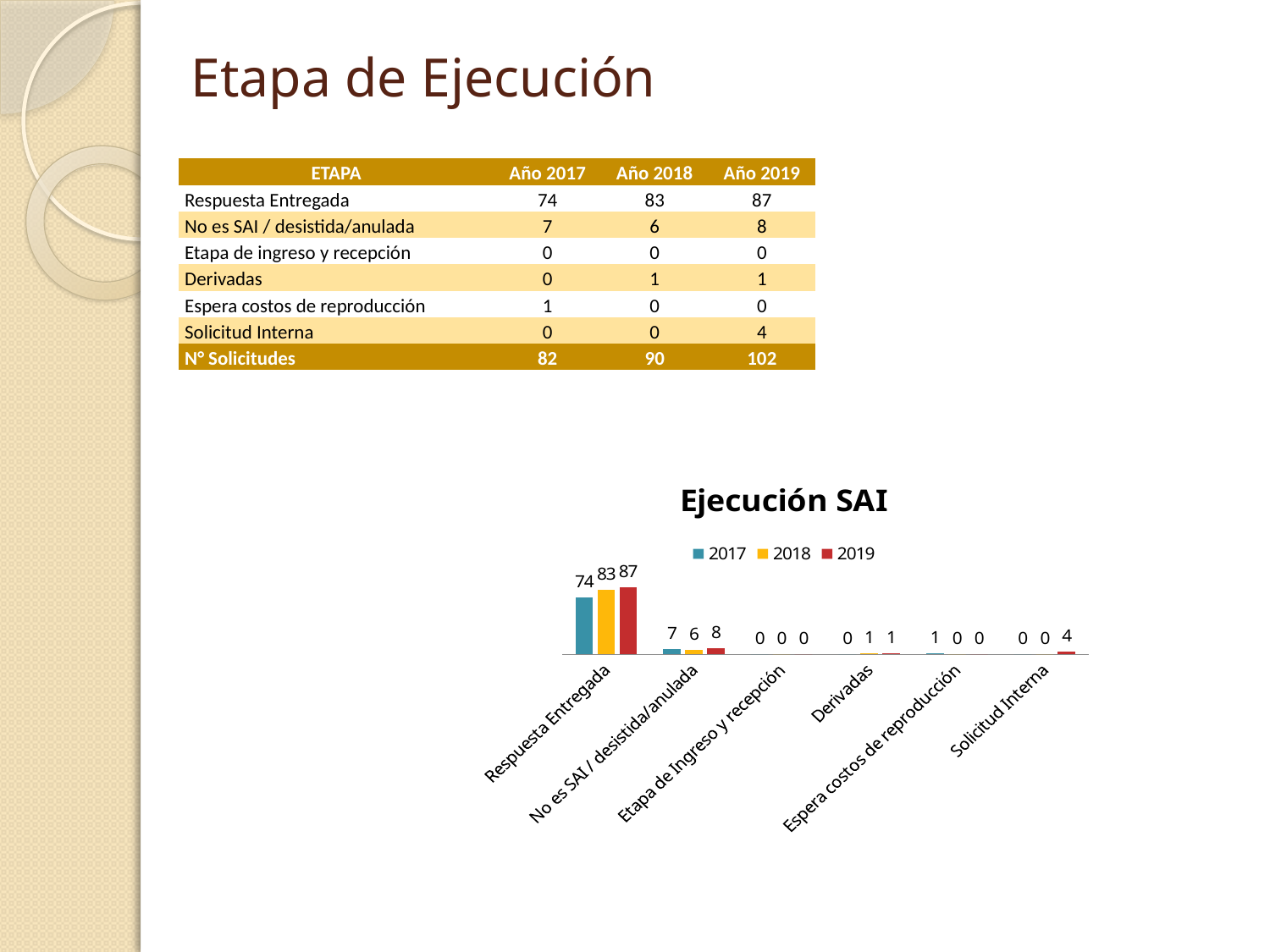
What kind of chart is shown on the slide? bar chart What is the title of the chart? Ejecución SAI How many series does the chart legend list? 3 Which is larger for No es SAI / desistida/anulada: the 2017 value or the 2019 value? 2019 What is the difference between the 2019 and 2017 values for Respuesta Entregada? 13 What is the value for Respuesta Entregada in 2019? 87 What is the value for Solicitud Interna in 2019? 4 What is the value for No es SAI / desistida/anulada in 2018? 6 Do the values for Respuesta Entregada rise or fall from 2017 to 2019? rise Which category has the highest value for the 2017 series? Respuesta Entregada How many categories are shown on the x axis of the chart? 6 What is the value for Espera costos de reproducción in 2017? 1